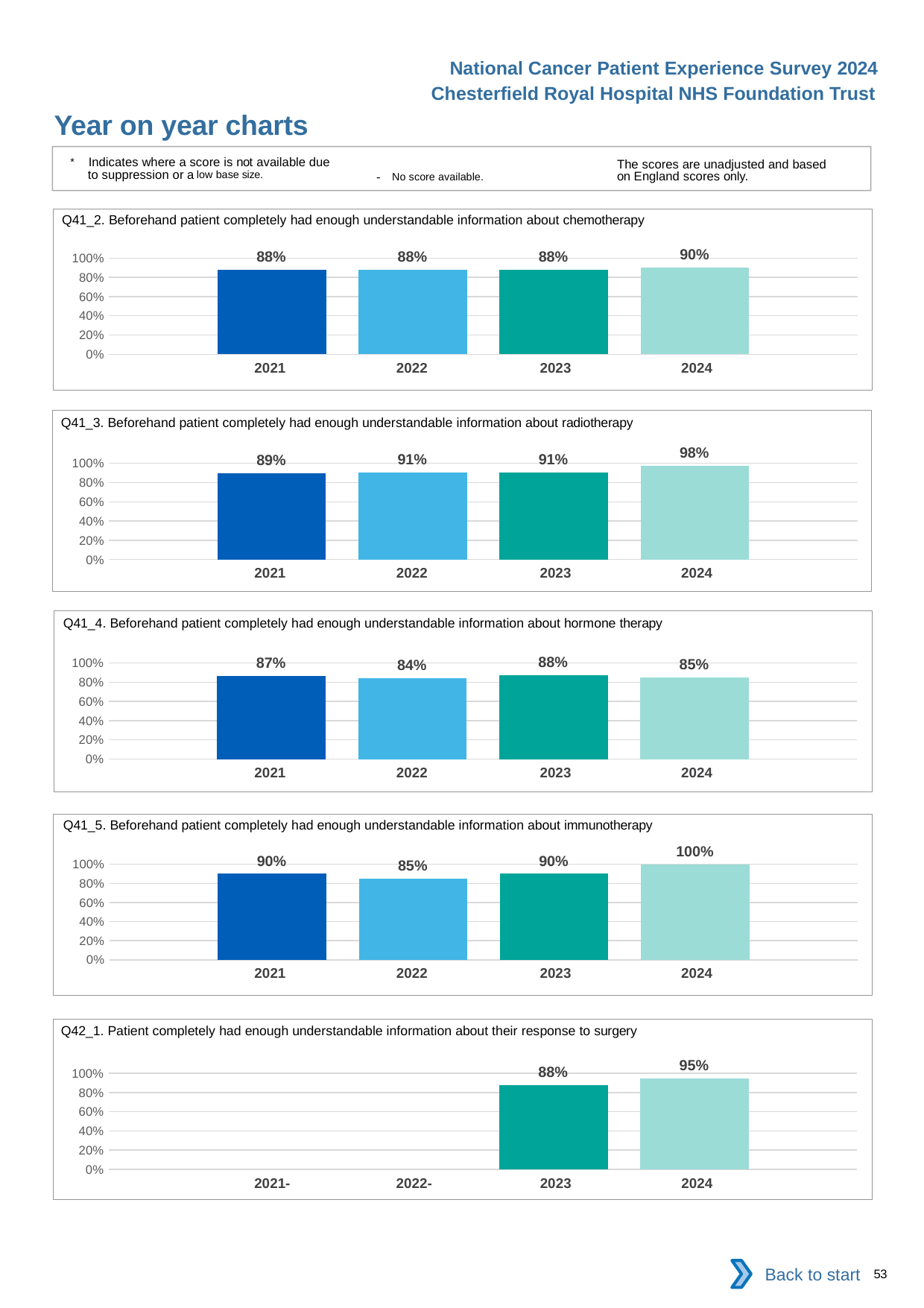
In the Q42_1 surgery chart, how many bars are plotted? 2 In the Q41_3 radiotherapy chart, what is the difference between the 2024 and 2021 values? 9 percentage points In the Q42_1 surgery chart, what is the difference between the 2024 and 2023 values? 7 percentage points What kind of chart is the Q41_2 chemotherapy chart? Bar chart In the Q41_4 hormone therapy chart, which year has the lowest value? 2022 In the Q41_3 radiotherapy chart, which year has the highest value? 2024 In the Q41_2 chemotherapy chart, what is the value for 2024? 90% In the Q41_5 immunotherapy chart, which is larger, the value for 2022 or the value for 2024? 2024 In the Q42_1 surgery chart, which years have no bar plotted? 2021 and 2022 In the Q41_4 hormone therapy chart, what is the value for 2023? 88% In the Q41_3 radiotherapy chart, do the values rise or fall from 2021 to 2024? Rise In the Q41_5 immunotherapy chart, what is the value for 2022? 85%